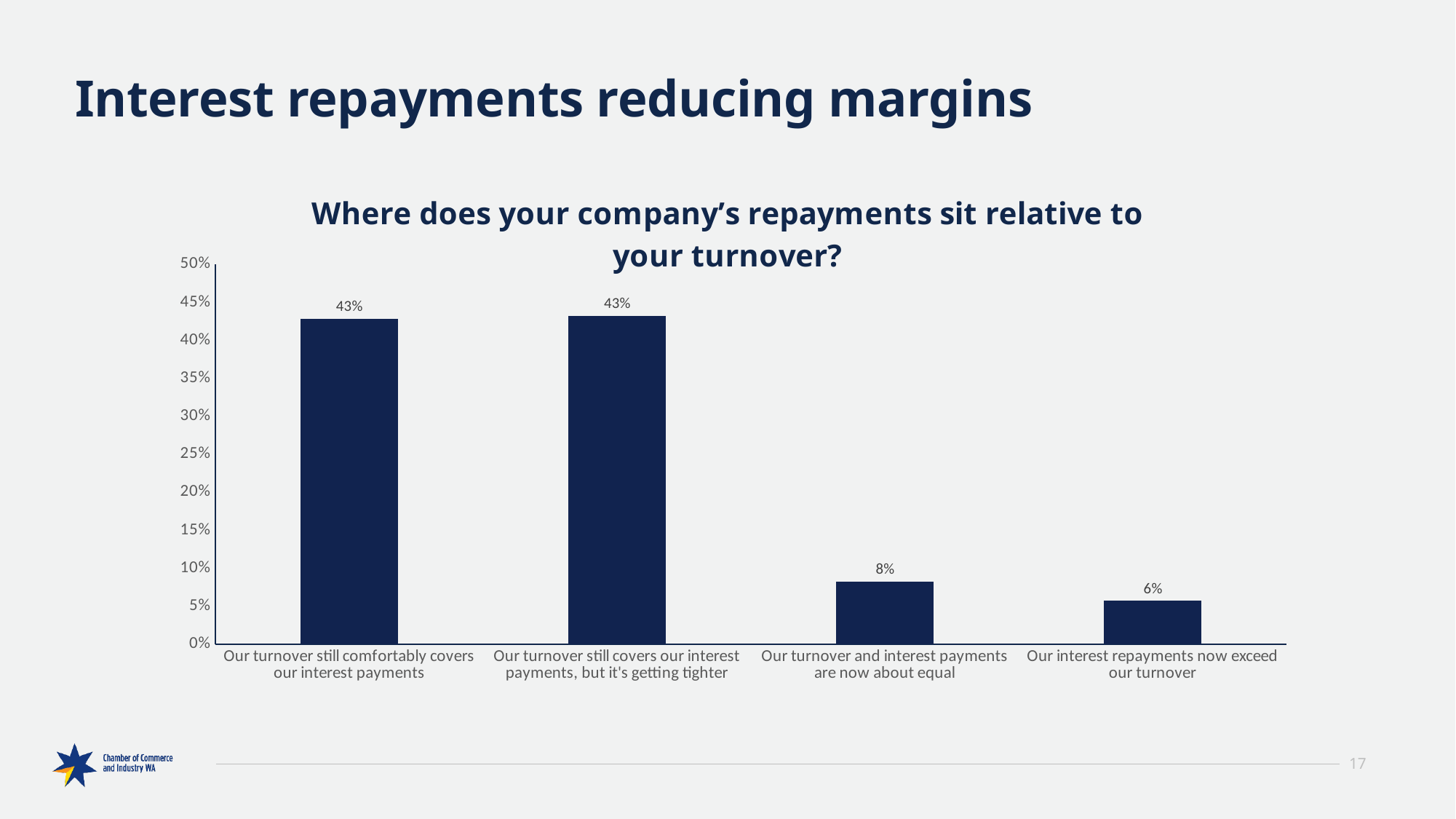
Is the value for 'Our turnover still covers our interest payments, but it's getting tighter' greater or less than 40%? greater Which is larger: the value for 'Our turnover and interest payments are now about equal' or the value for 'Our interest repayments now exceed our turnover'? Our turnover and interest payments are now about equal What percentage of respondents said their turnover still covers their interest payments, but it's getting tighter? 43% Which response category has the lowest value? Our interest repayments now exceed our turnover What percentage of respondents said their interest repayments now exceed their turnover? 6% What percentage of respondents said their turnover still comfortably covers their interest payments? 43% What kind of chart is shown on the slide? Bar chart What is the title of the chart? Where does your company's repayments sit relative to your turnover? What is the difference between the value for 'Our turnover and interest payments are now about equal' and the value for 'Our interest repayments now exceed our turnover'? 2% What percentage of respondents said their turnover and interest payments are now about equal? 8% How many response categories are shown on the chart? 4 What is the difference between the value for 'Our turnover still comfortably covers our interest payments' and the value for 'Our turnover and interest payments are now about equal'? 35%